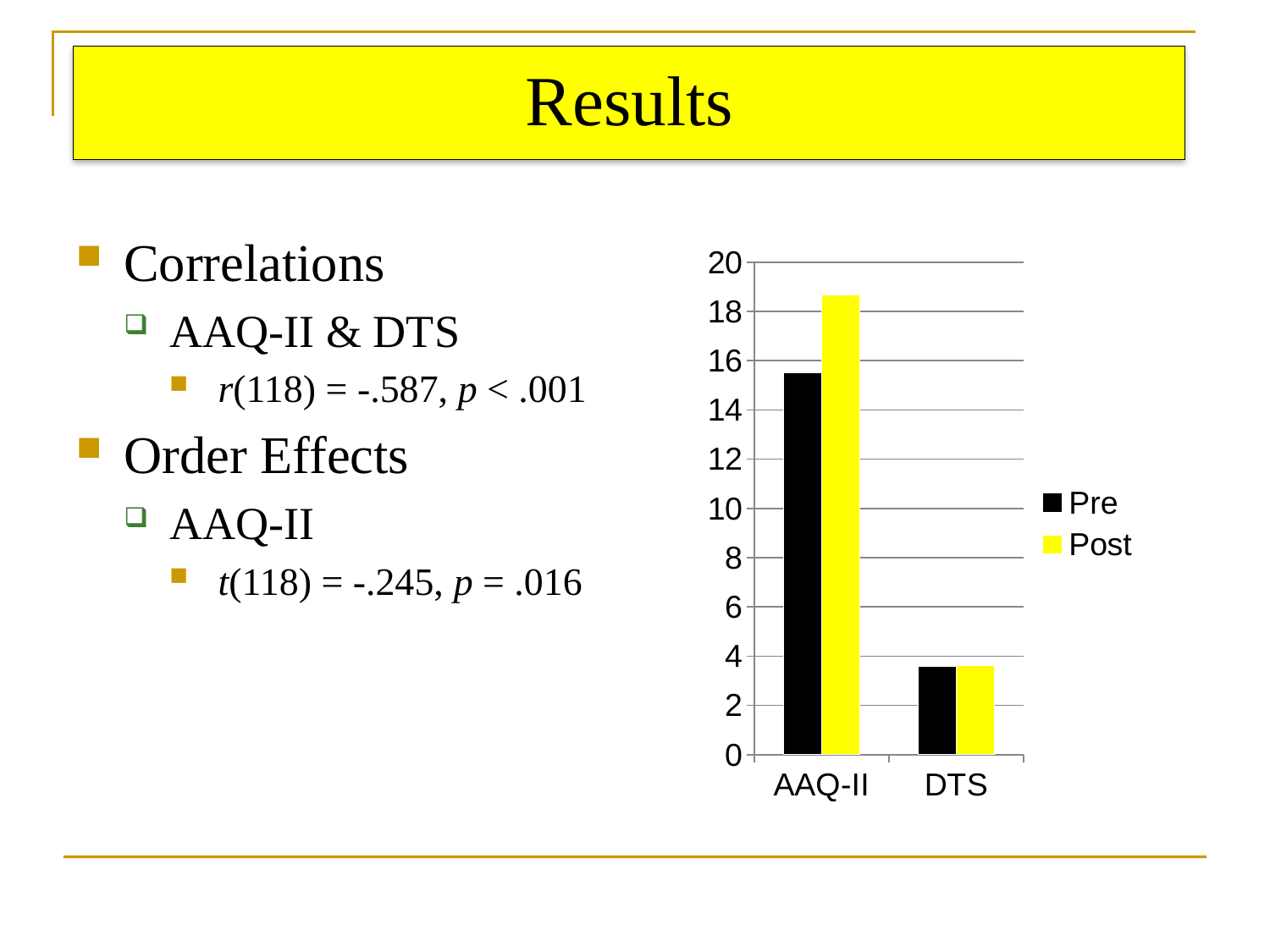
What colour are the Post bars in the chart? yellow For AAQ-II, which is larger, the Pre value or the Post value? Post Which category has the higher Pre value, AAQ-II or DTS? AAQ-II Is the Post value for DTS greater or less than 2? greater Is the Pre value for DTS greater or less than 4? less What kind of chart is shown on the slide? bar chart How many categories are shown on the x axis of the chart? 2 Which series are listed in the chart's legend? Pre and Post Is the Pre value for AAQ-II greater or less than 14? greater How many series does the chart's legend list? 2 Which bar in the chart is the tallest? Post for AAQ-II